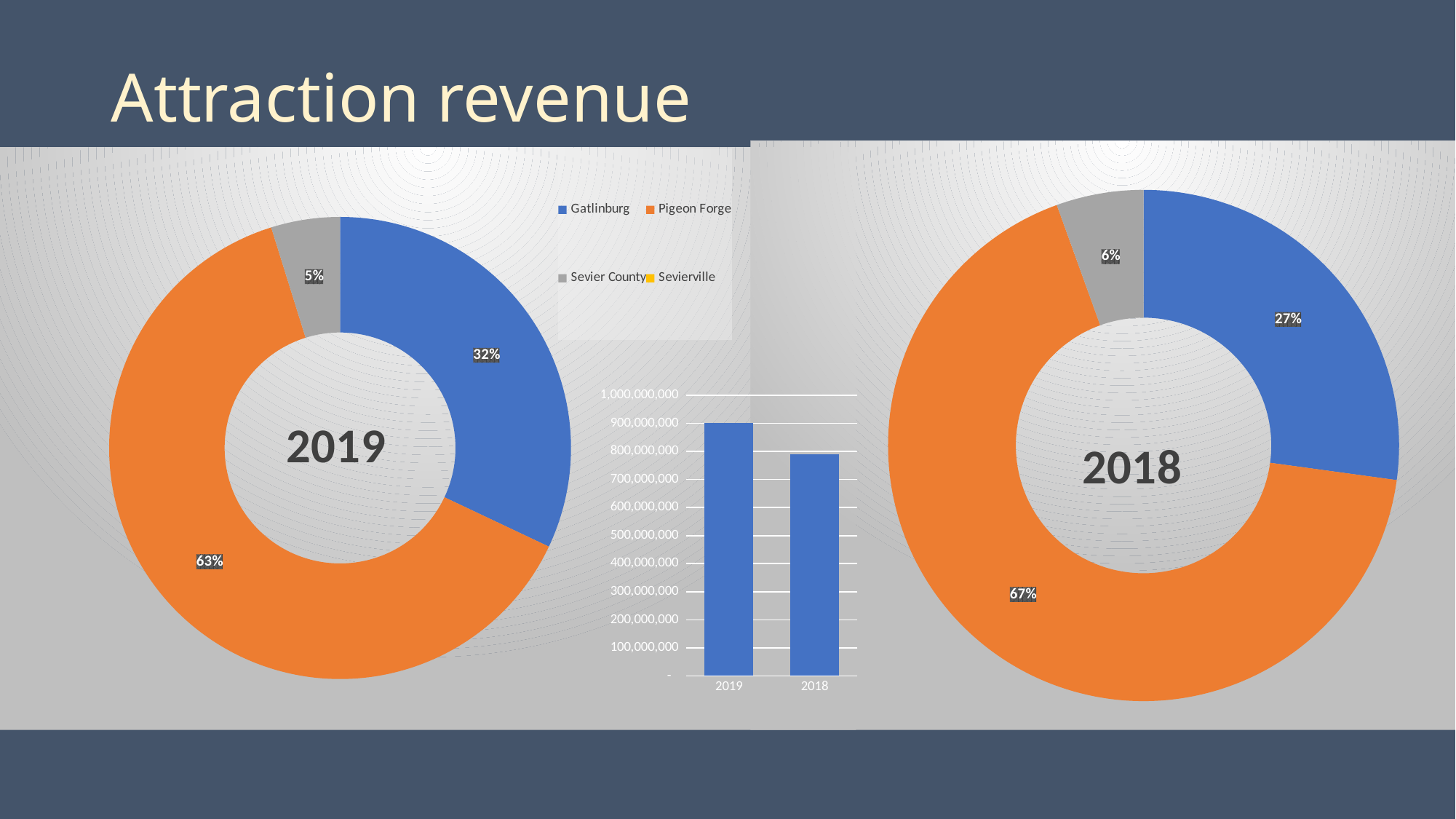
In the bar chart in the middle of the slide, which year has the taller bar? 2019 In the 2018 doughnut chart, which category has the largest share? Pigeon Forge What is the difference between Pigeon Forge's share and Gatlinburg's share in the 2019 doughnut chart? 31% Is Gatlinburg's share larger in the 2019 doughnut chart or the 2018 doughnut chart? 2019 In the bar chart in the middle of the slide, is the value for 2019 greater or less than 800,000,000? greater How many entries does the legend on the slide list? 4 In the 2018 doughnut chart, what share does Pigeon Forge have? 67% In the 2019 doughnut chart, what share of attraction revenue does Pigeon Forge have? 63% In the 2019 doughnut chart, which category has the smallest share? Sevier County In the bar chart in the middle of the slide, is the value for 2018 greater or less than 700,000,000? greater In the 2019 doughnut chart, what share does Gatlinburg have? 32%